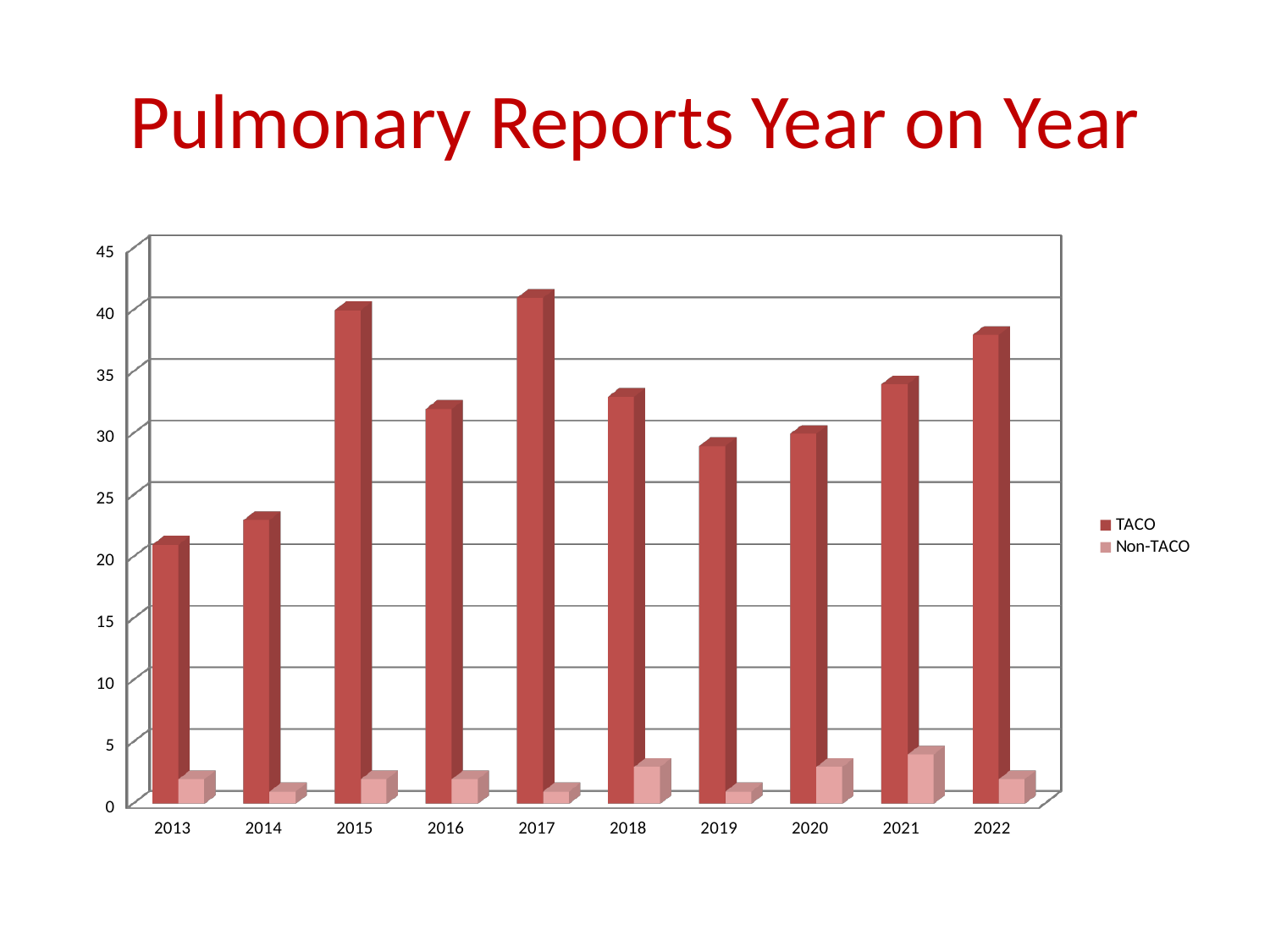
Is the TACO value for 2015 greater or less than 35? greater How many years are shown on the x axis? 10 Is the Non-TACO value for 2021 greater or less than 5? less How many series does the legend list? 2 Which year has the highest Non-TACO value? 2021 What is the title of the chart? Pulmonary Reports Year on Year Which year has the larger TACO value, 2021 or 2022? 2022 Which year has the lowest TACO value? 2013 What kind of chart is shown on the slide? bar chart Do the TACO values rise or fall from 2013 to 2015? rise Which year has the highest TACO value? 2017 Is the TACO value for 2013 greater or less than 25? less